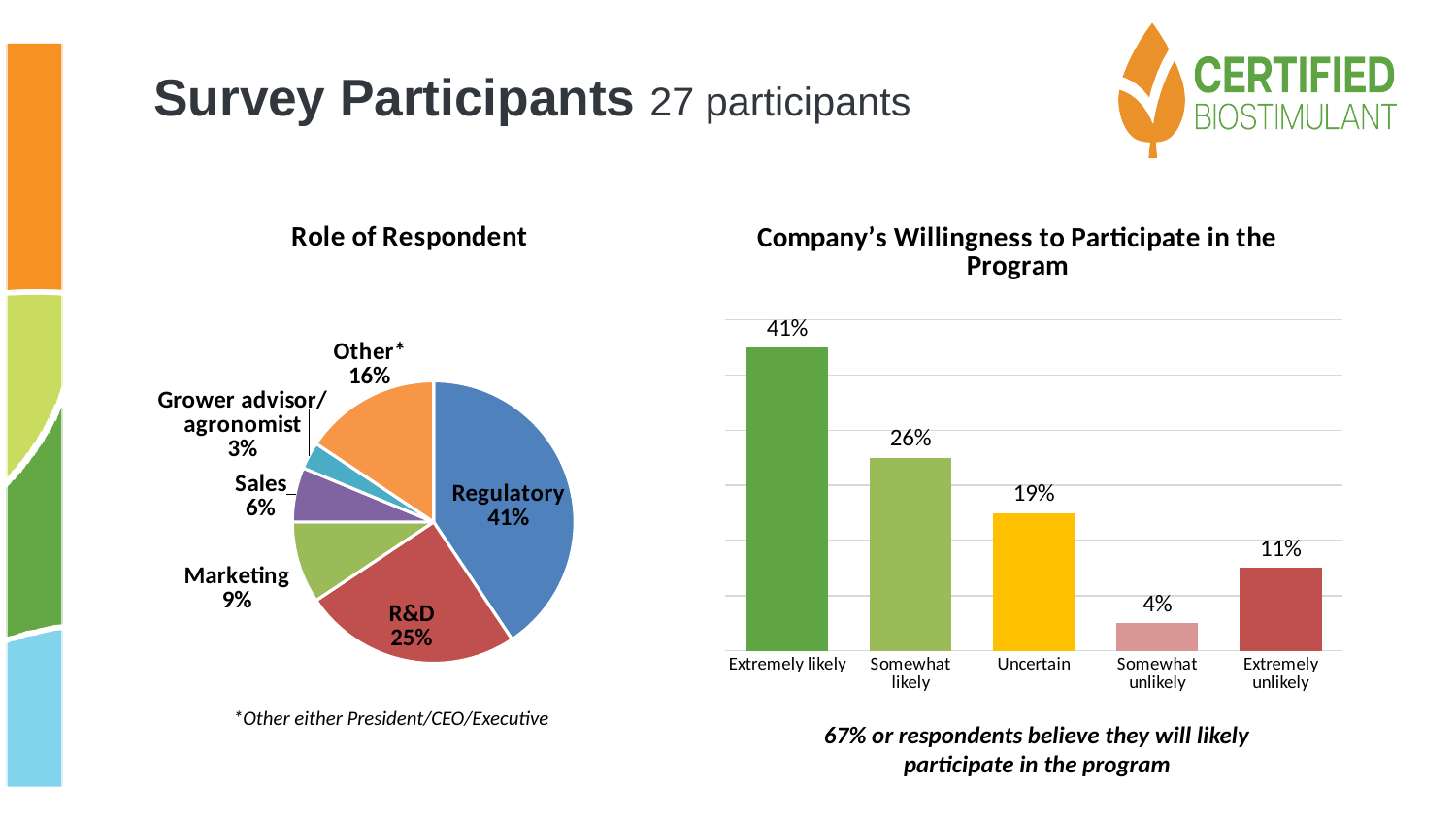
In the 'Company's Willingness to Participate in the Program' chart, which category has the lowest value? Somewhat unlikely In the 'Role of Respondent' chart, how many slices does the pie have? 6 In the 'Company's Willingness to Participate in the Program' chart, what is the difference between Uncertain and Extremely unlikely? 8% In the 'Role of Respondent' chart, what is the difference between the Other* share and the Marketing share? 7% In the 'Company's Willingness to Participate in the Program' chart, what is the value for Somewhat likely? 26% In the 'Company's Willingness to Participate in the Program' chart, which category has the highest value? Extremely likely In the 'Role of Respondent' chart, what share of respondents are in R&D? 25% What kind of chart is 'Company's Willingness to Participate in the Program'? Bar chart What kind of chart is 'Role of Respondent'? Pie chart In the 'Role of Respondent' chart, which role has the smallest share? Grower advisor/agronomist In the 'Role of Respondent' chart, what share of respondents are in Regulatory? 41% In the 'Company's Willingness to Participate in the Program' chart, which is larger: Somewhat likely or Uncertain? Somewhat likely